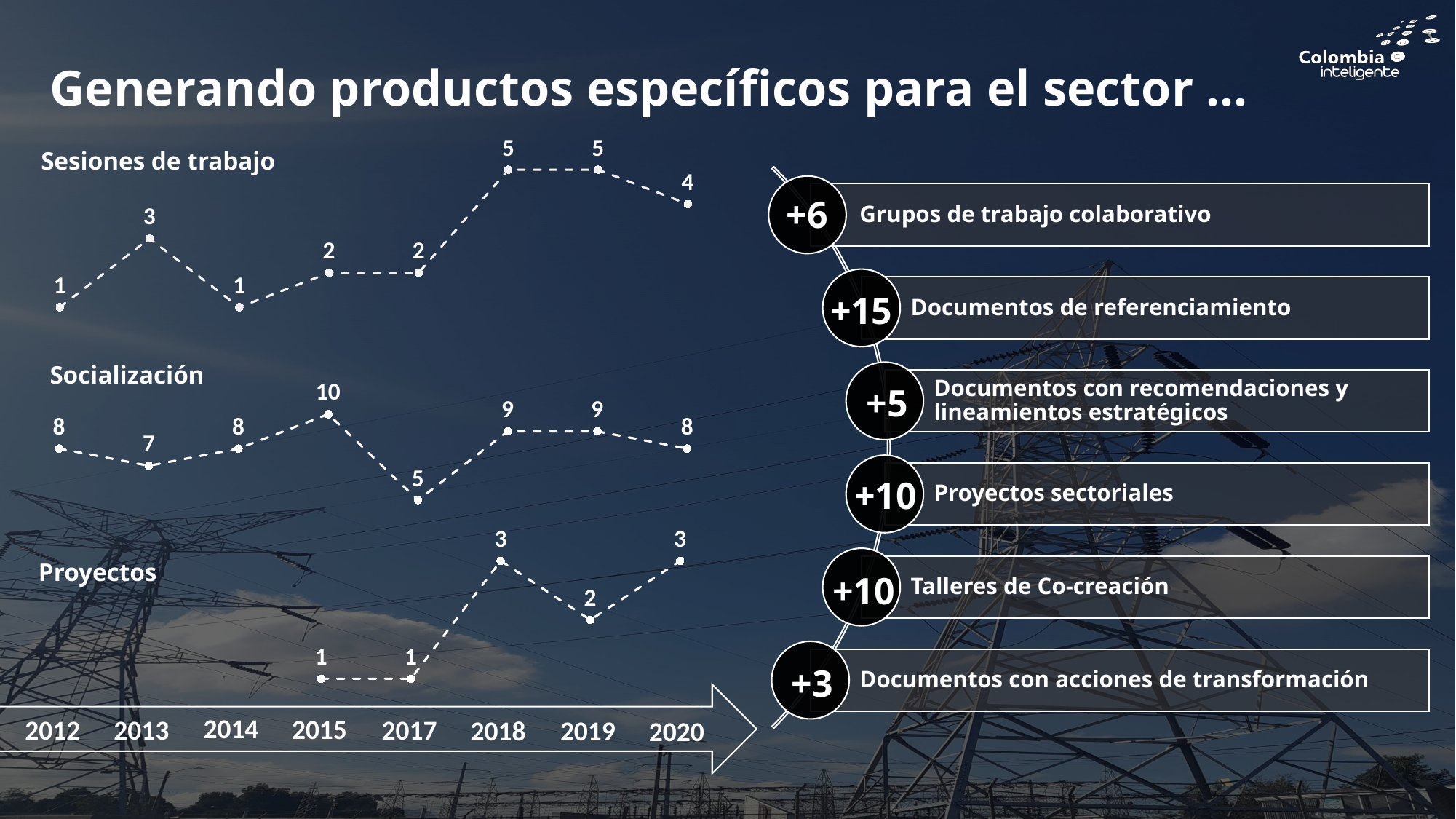
In the 'Sesiones de trabajo' chart, what is the value for 2018? 5 In the 'Socialización' chart, which year has the highest value? 2015 In the 'Socialización' chart, which year has the lowest value? 2017 In the 'Proyectos' chart, what is the value for 2019? 2 In the 'Sesiones de trabajo' chart, what is the difference between the values for 2018 and 2012? 4 In the 'Sesiones de trabajo' chart, does the value rise or fall from 2019 to 2020? Fall In the 'Sesiones de trabajo' chart, which is larger, the value for 2013 or the value for 2020? 2020 In the 'Proyectos' chart, which is larger, the value for 2018 or the value for 2019? 2018 In the 'Socialización' chart, what is the value for 2017? 5 What kind of chart is used for 'Sesiones de trabajo'? Line chart In the 'Socialización' chart, what is the difference between the values for 2015 and 2017? 5 How many data points are plotted in the 'Proyectos' chart? 5